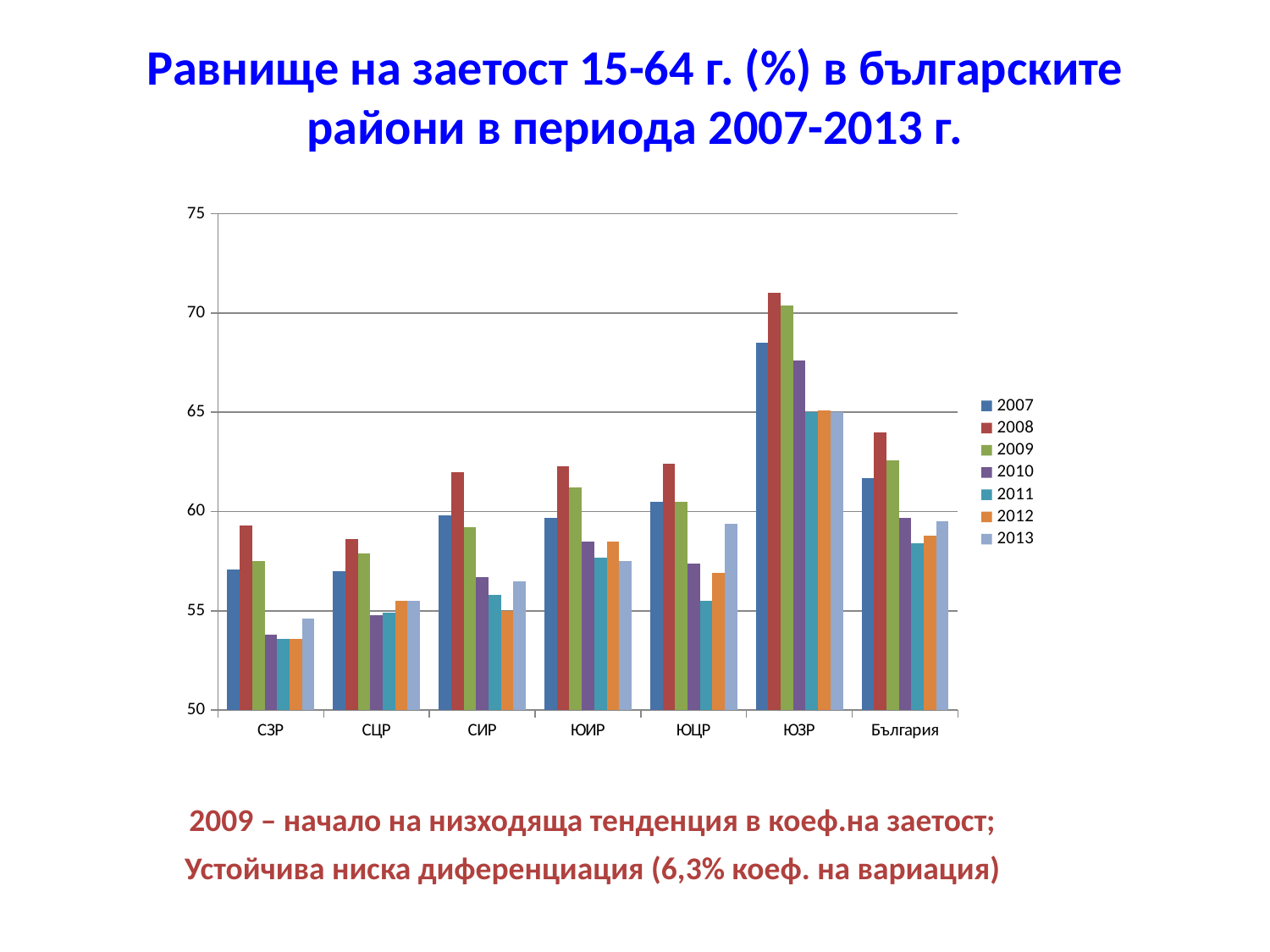
For България, which year has the highest value? 2008 For България, do the values rise or fall from 2008 to 2011? fall Is the value for ЮЗР in 2008 greater or less than 70? greater Which region has the highest employment rate in 2008? ЮЗР How many series does the legend list? 7 What kind of chart is shown on the slide? bar chart Is the value for ЮИР in 2008 greater or less than 60? greater How many regions (categories) are shown on the x axis? 7 What is the title of the chart? Равнище на заетост 15-64 г. (%) в българските райони в периода 2007-2013 г. Which region has the lowest employment rate in 2013? СЗР Is the value for СЗР in 2011 greater or less than 55? less Which is larger: the 2007 value for ЮЗР or the 2007 value for България? ЮЗР